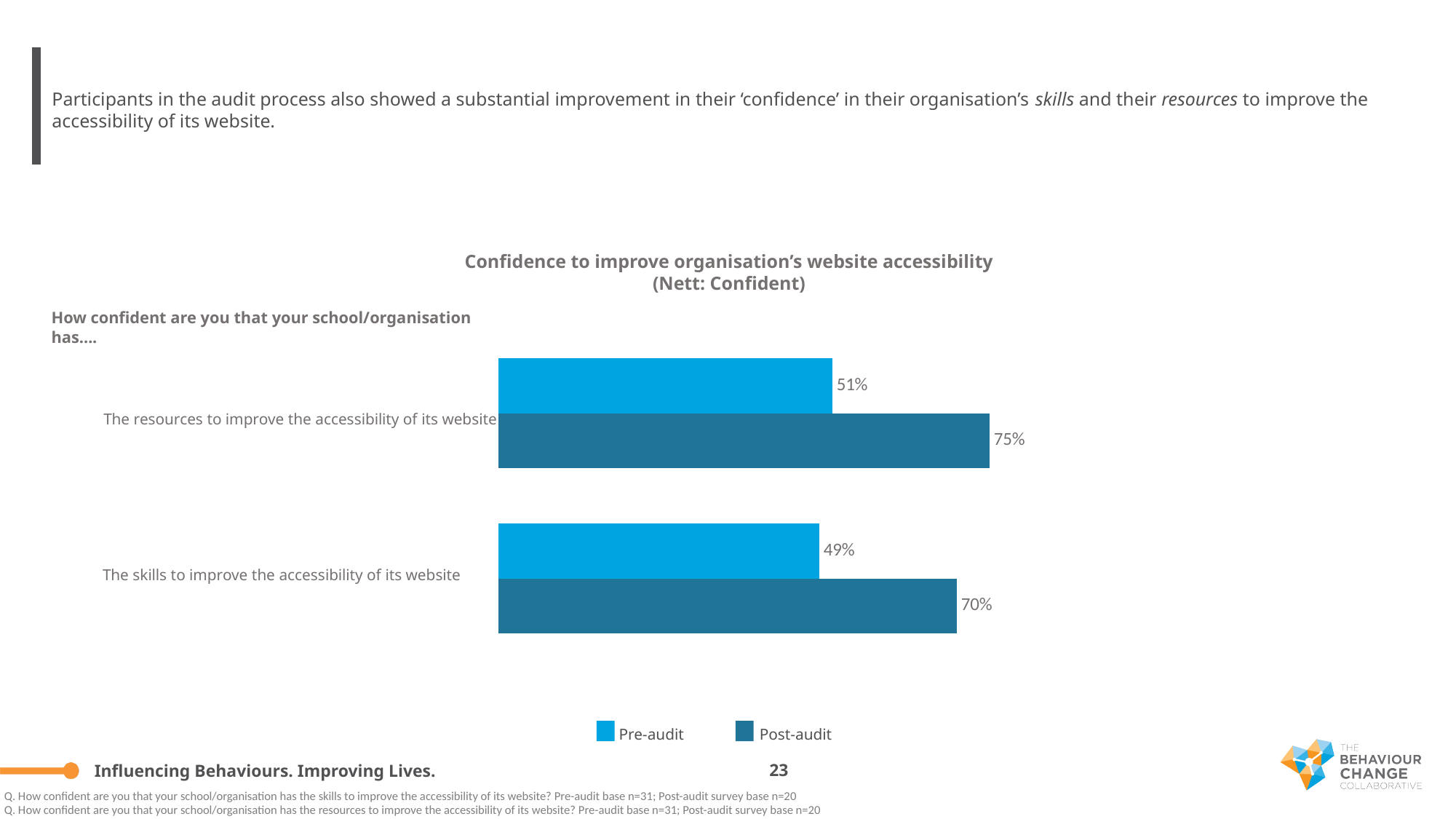
Which category has the lowest Pre-audit value? The skills to improve the accessibility of its website What is the difference between the Post-audit and Pre-audit values for 'The resources to improve the accessibility of its website'? 24% What is the Pre-audit value for 'The resources to improve the accessibility of its website'? 51% What is the difference between the Post-audit and Pre-audit values for 'The skills to improve the accessibility of its website'? 21% What kind of chart is shown on the slide? Bar chart How many series does the legend list? 2 Which category has the highest Post-audit value? The resources to improve the accessibility of its website Which is larger: the Pre-audit value for resources or the Post-audit value for skills? Post-audit value for skills What is the Pre-audit value for 'The skills to improve the accessibility of its website'? 49% How many categories are shown in the chart? 2 What is the Post-audit value for 'The skills to improve the accessibility of its website'? 70% What is the Post-audit value for 'The resources to improve the accessibility of its website'? 75%